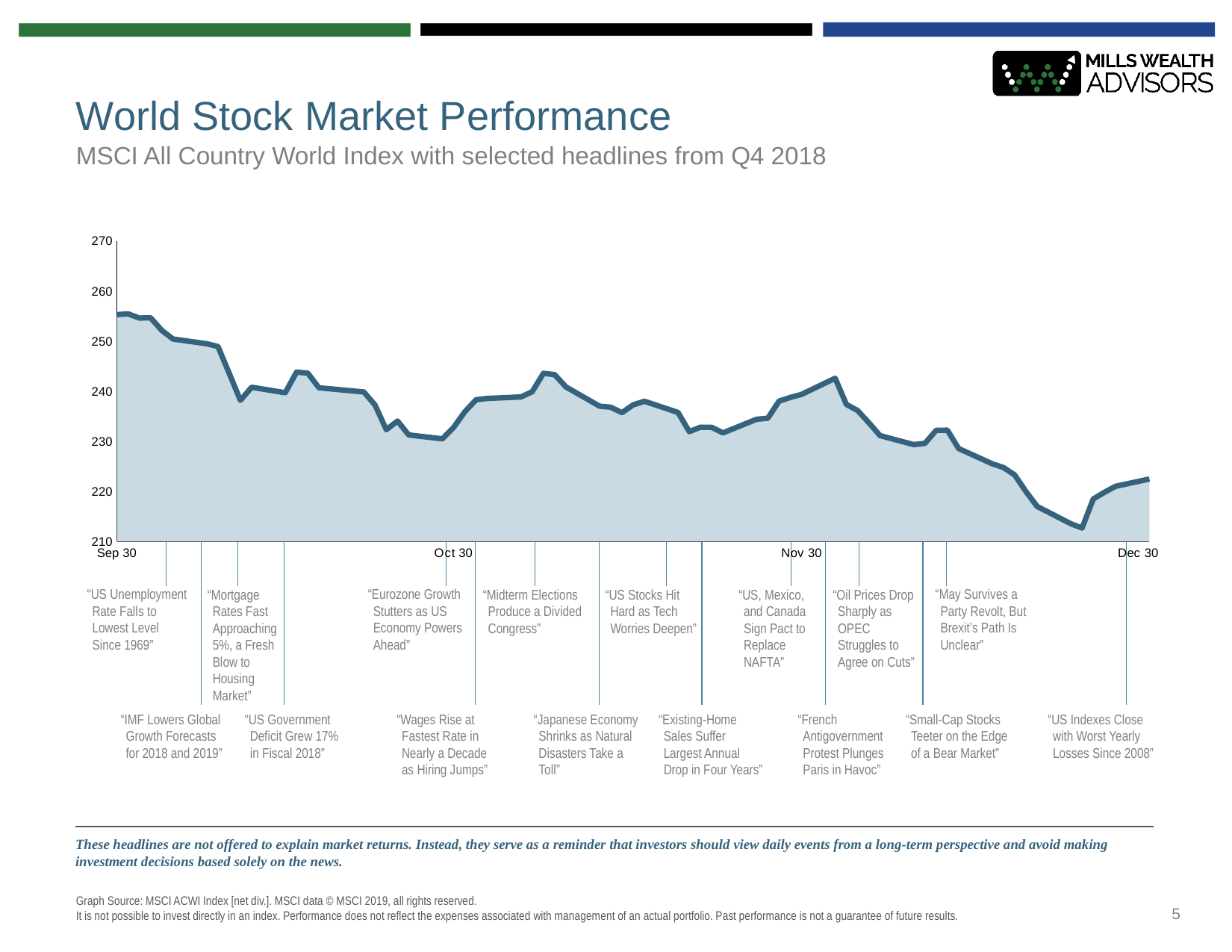
Is the index value at Sep 30 greater or less than 250? greater What kind of chart is shown on the slide? area chart In which month does the index reach its lowest point? December Is the index value at Nov 30 greater or less than 230? greater Is the index value at Dec 30 greater or less than 230? less What is the title of the chart on the slide? World Stock Market Performance Which is larger, the index value at Sep 30 or at Dec 30? Sep 30 Overall, do the index values rise or fall from Sep 30 to Dec 30? fall Which index does the chart plot, according to the subtitle? MSCI All Country World Index At which labelled date on the x axis is the index at its highest? Sep 30 How many date labels are shown on the x axis? 4